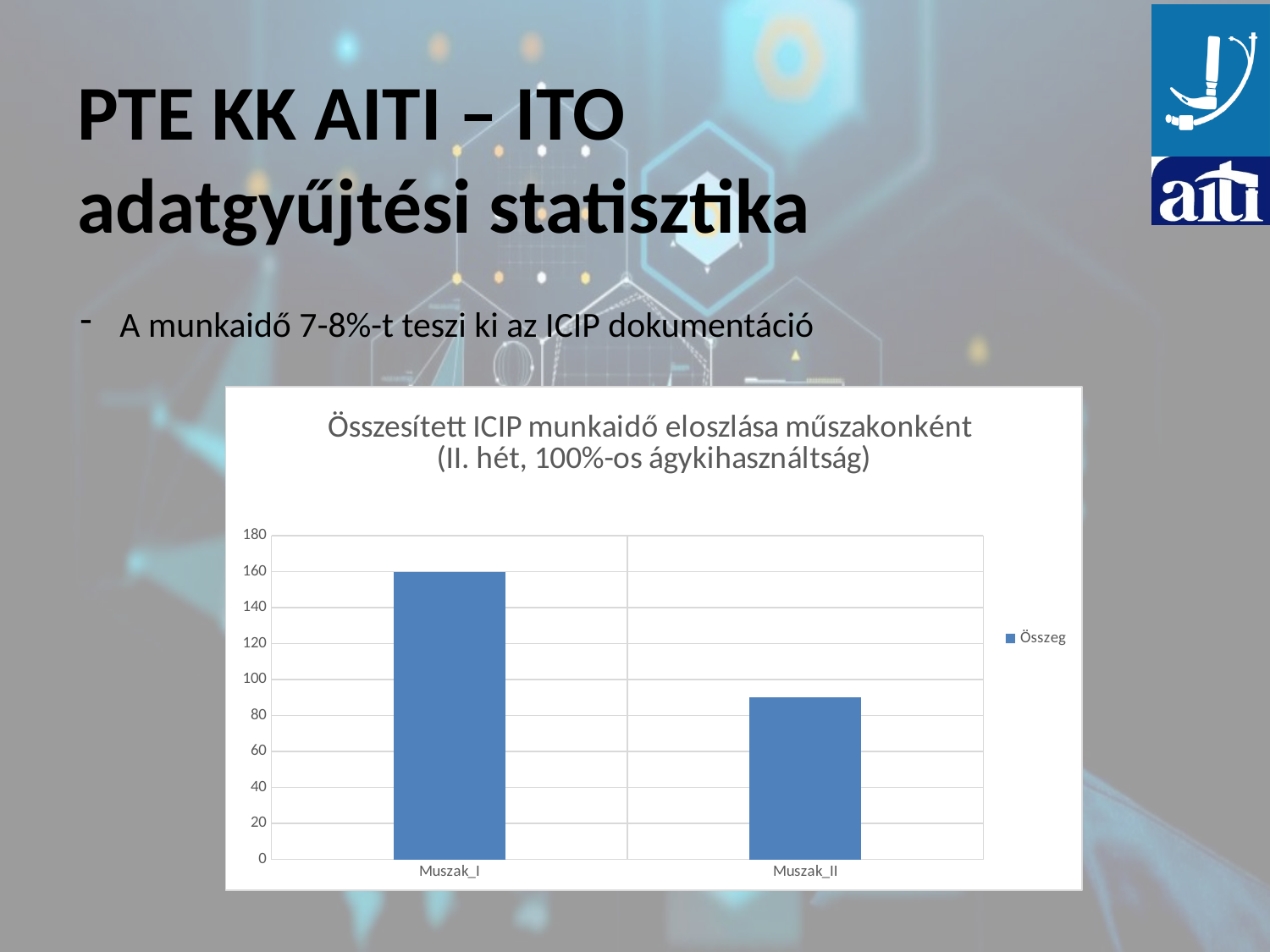
How many series does the chart's legend list? 1 What is the name of the series listed in the chart's legend? Összeg Is the value for Muszak_II greater or less than 80? greater Do the values rise or fall from Muszak_I to Muszak_II? fall Is the value for Muszak_II greater or less than 100? less What is the title of the chart? Összesített ICIP munkaidő eloszlása műszakonként (II. hét, 100%-os ágykihasználtság) How many categories are shown on the x axis of the chart? 2 Which category has the highest value in the chart? Muszak_I What kind of chart is shown on the slide? bar chart Which is larger, the value for Muszak_I or the value for Muszak_II? Muszak_I Is the value for Muszak_I greater or less than 140? greater Which category has the lowest value in the chart? Muszak_II